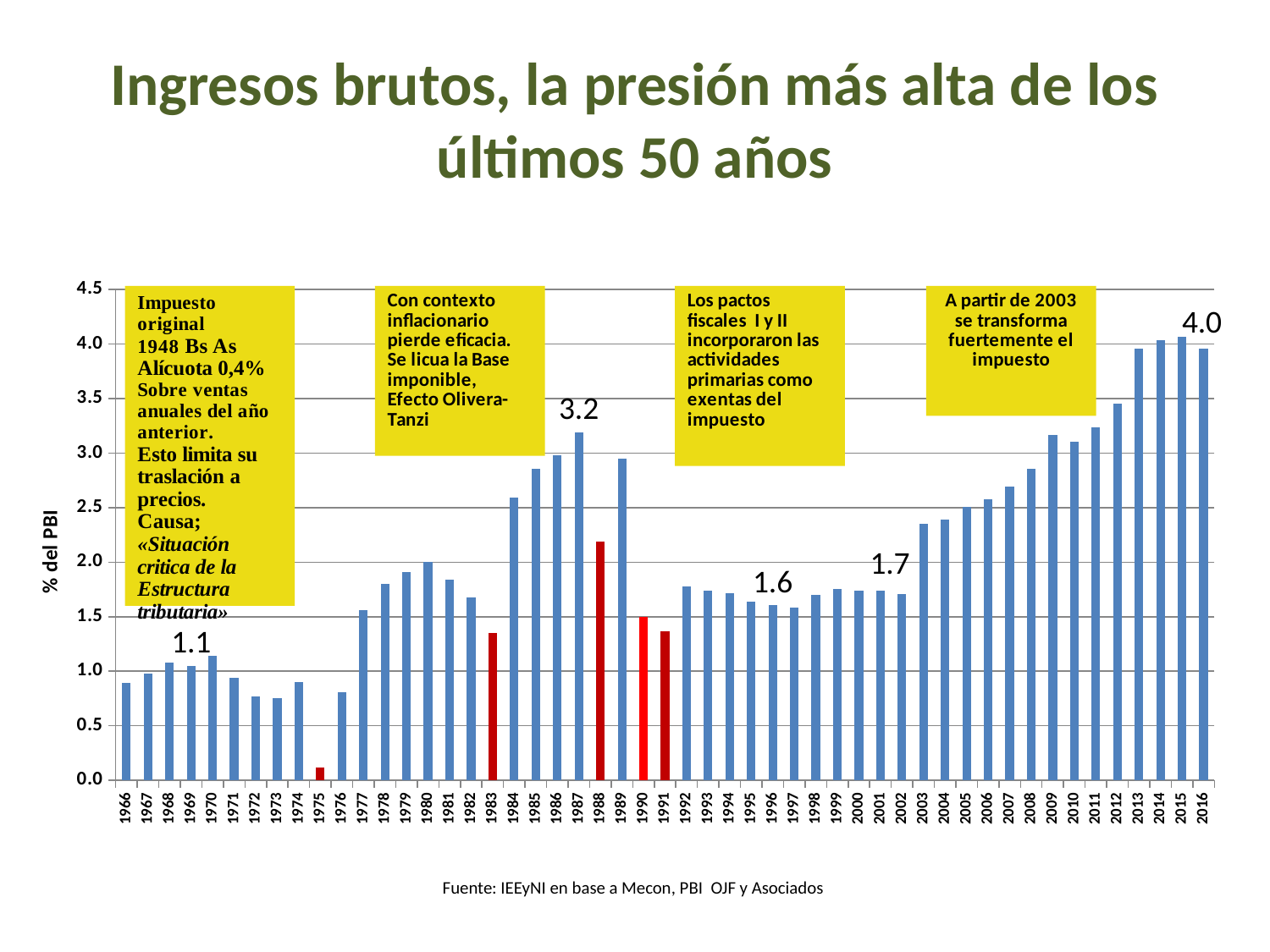
Do the values generally rise or fall from 2003 to 2016? rise What kind of chart is shown on the slide? bar chart Which year has the larger value, 1987 or 1988? 1987 Which year has the lowest value in the chart? 1975 How many bars are coloured red in the chart? 5 What is the label of the vertical axis of the chart? % del PBI Is the value for 1975 greater or less than 0.5? less What value is labelled above the tallest bars at the right end of the chart (2015)? 4.0 Is the value for 1966 greater or less than 1.0? less Is the value for 1990 greater or less than 2.0? less What value is labelled above the 1987 bar? 3.2